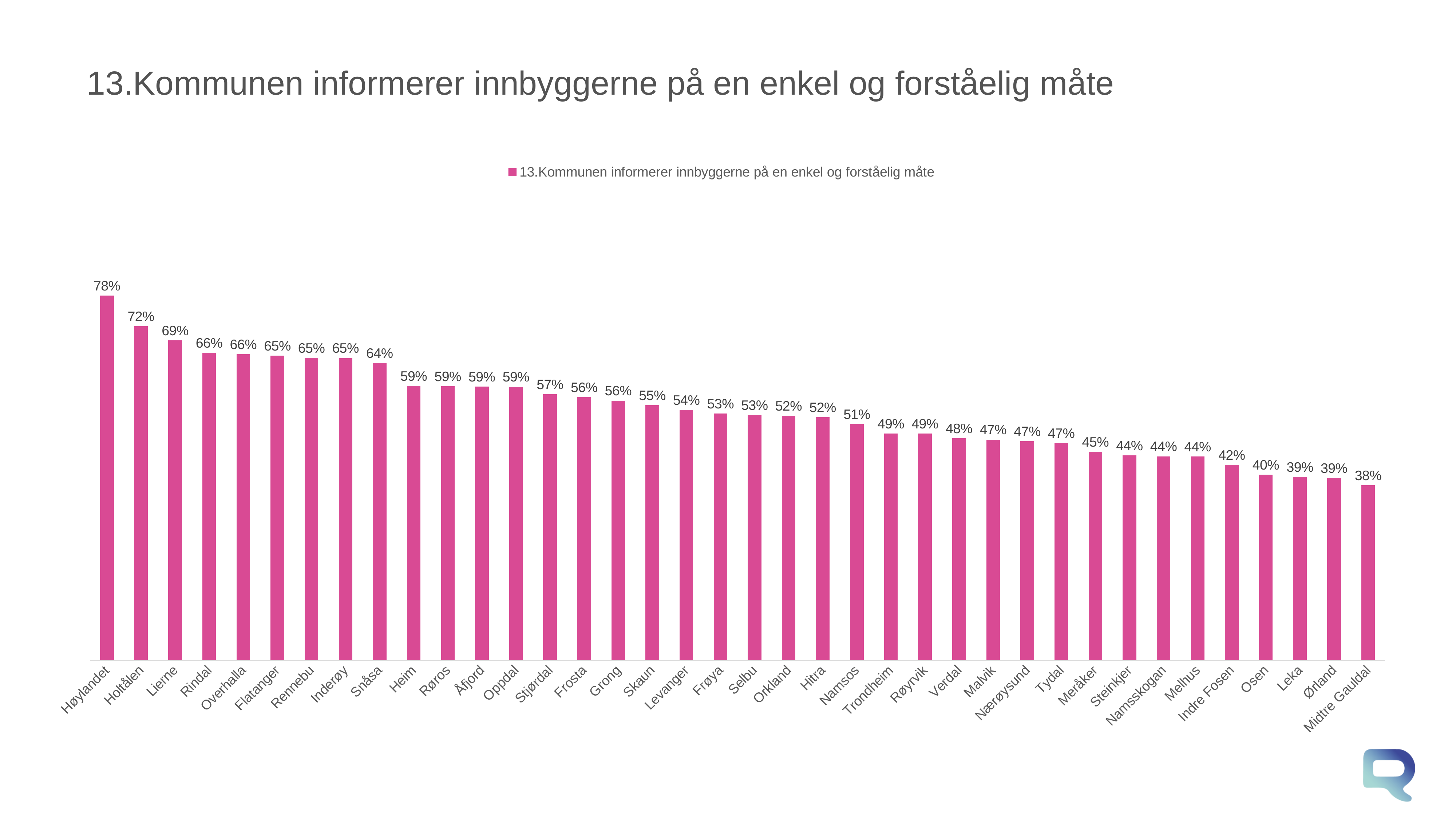
What is the difference between the values for Høylandet and Midtre Gauldal? 40% What kind of chart is shown on the slide? Bar chart Which municipality has the highest value? Høylandet How many municipalities are shown on the x axis? 38 What is the difference between the values for Holtålen and Namsos? 21% Which has a larger value, Lierne or Levanger? Lierne How many series does the legend list? 1 What is the value for Høylandet? 78% What is the value for Trondheim? 49% Do the values rise or fall from left to right along the x axis? Fall What is the value for Stjørdal? 57% Which municipality has the lowest value? Midtre Gauldal